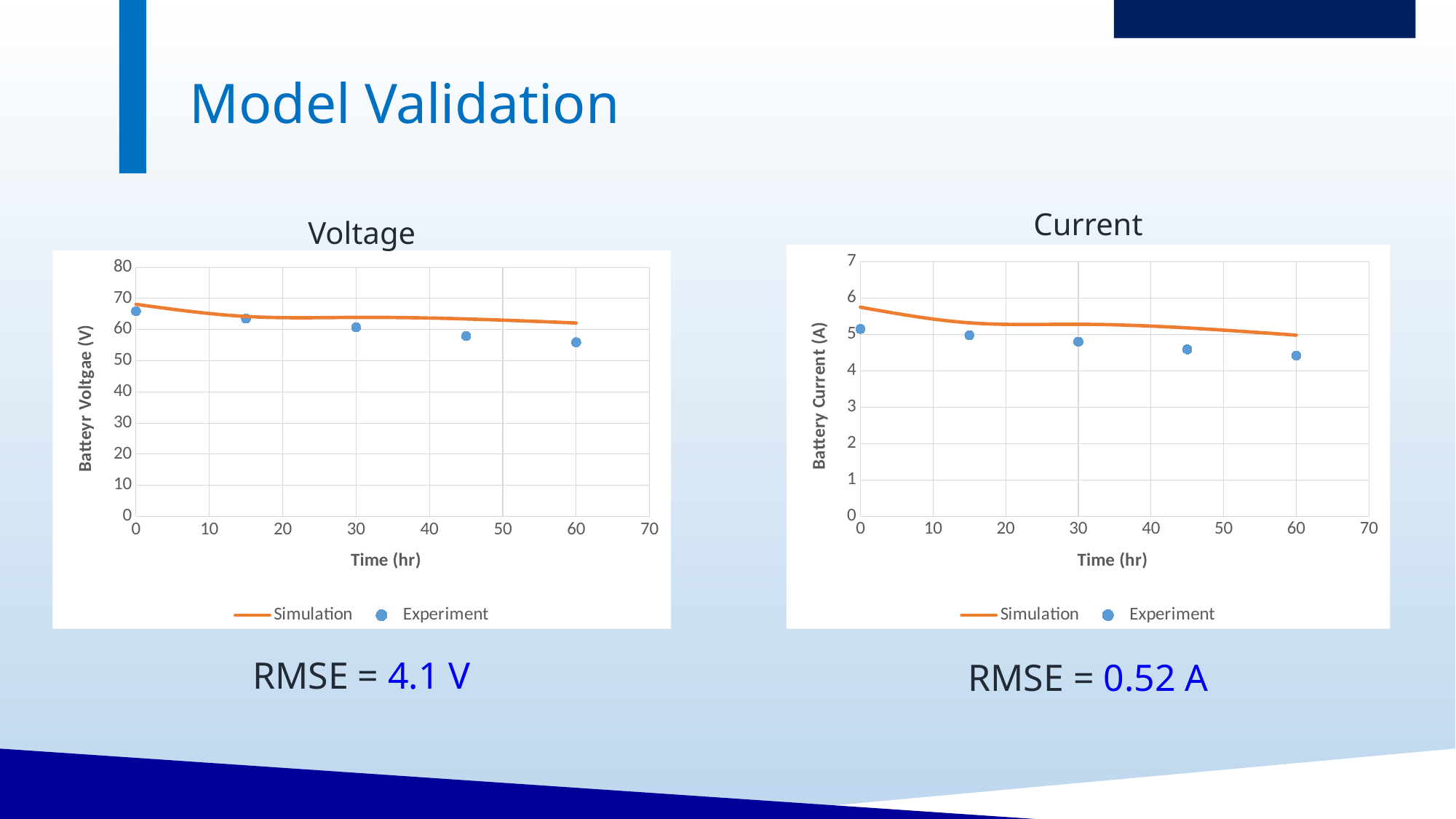
What is the y-axis label of the Current chart? Battery Current (A) In the Current chart, how many Experiment data points are plotted? 5 In the Current chart, is the Experiment value at 60 hr greater or less than 5? less What kind of chart is the Voltage chart? line chart with scatter points In the Voltage chart, do the Experiment values rise or fall as time increases? fall In the Voltage chart, is the Experiment value at 60 hr greater or less than 60? less In the Current chart, which is larger: the Experiment value at 0 hr or at 60 hr? 0 hr How many series does the legend of the Current chart list? 2 In the Voltage chart, how many Experiment data points are plotted? 5 In the Current chart, is the Simulation value at 0 hr greater or less than 5? greater In the Voltage chart, at which time is the Experiment value highest? 0 hr In the Current chart, does the Simulation line rise or fall as time increases? fall